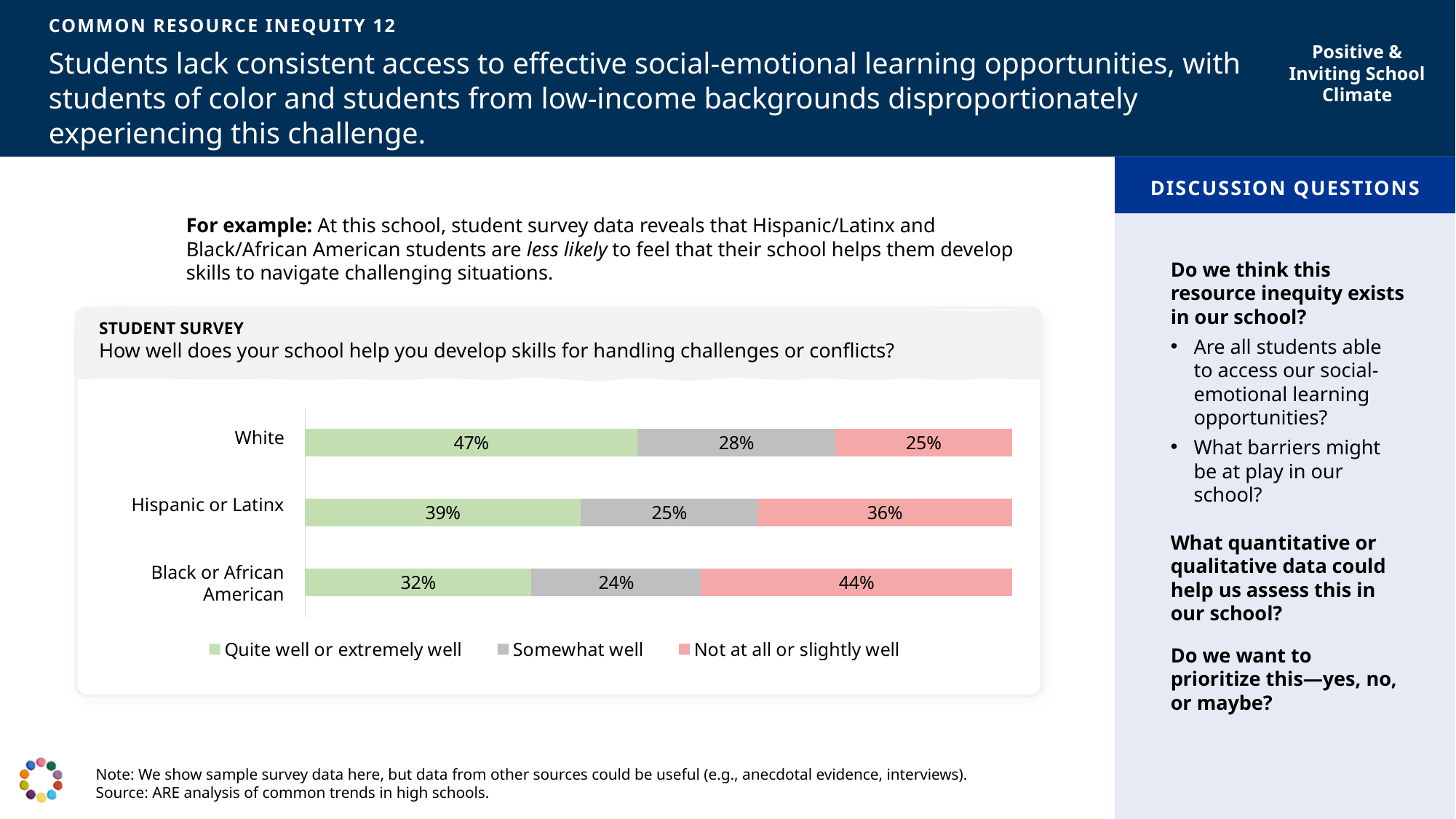
Which group has the highest share answering "Not at all or slightly well"? Black or African American What survey question does the chart show responses to? How well does your school help you develop skills for handling challenges or conflicts? Which group has the lowest share answering "Quite well or extremely well"? Black or African American How many response categories does the legend list? 3 What kind of chart is shown on the slide? Stacked bar chart What is the difference between the "Quite well or extremely well" shares for White and Black or African American students? 15 percentage points What percentage of Hispanic or Latinx students answered "Not at all or slightly well"? 36% How many student groups are shown in the chart? 3 What percentage of White students answered "Quite well or extremely well"? 47% What percentage of Black or African American students answered "Somewhat well"? 24% What is the total of the three segments for the Hispanic or Latinx bar? 100% Which is larger: the "Somewhat well" share for White students or for Hispanic or Latinx students? White